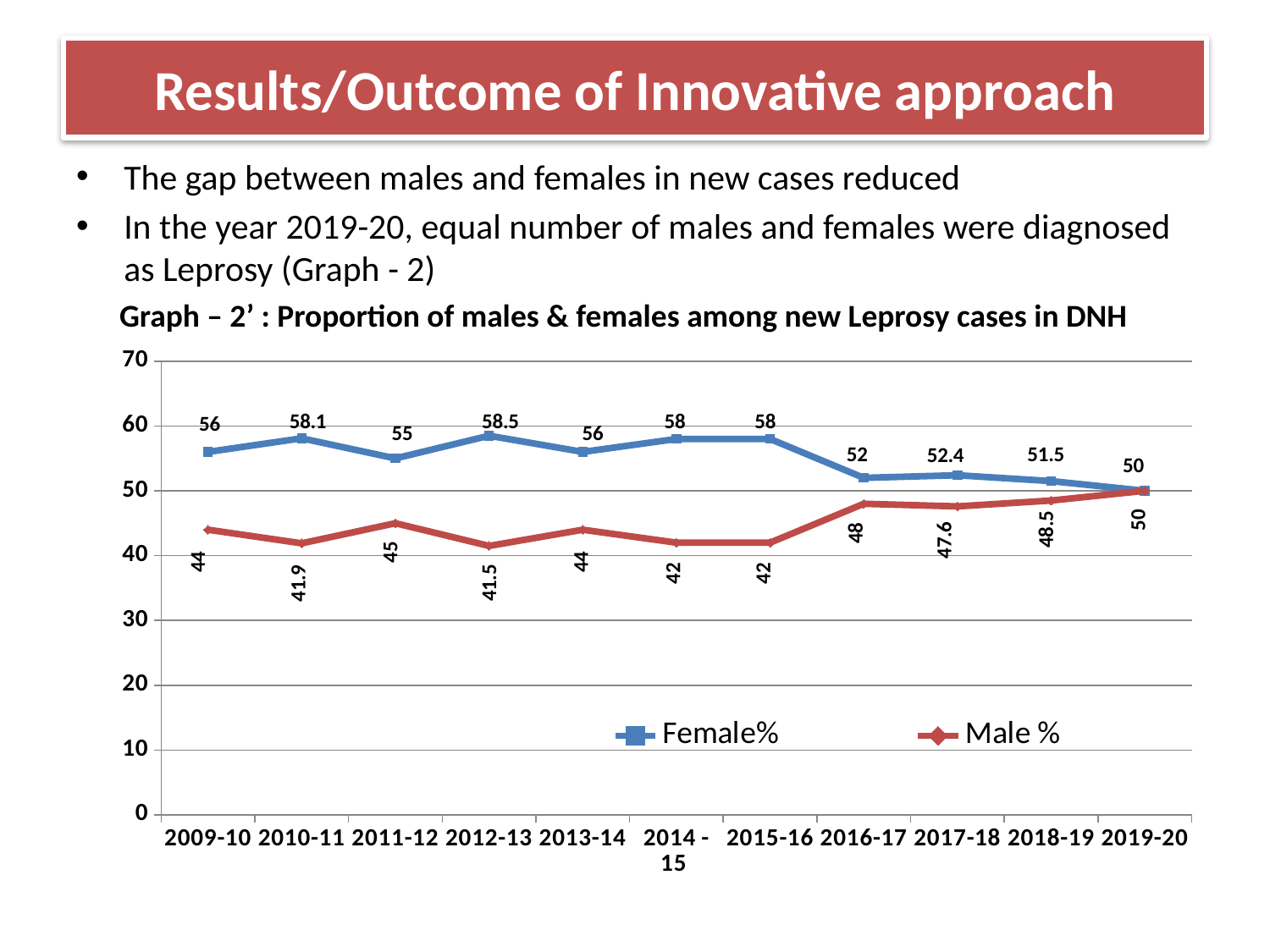
How many years are shown on the x axis? 11 What kind of chart is shown? Line chart In which year is the Male % value highest? 2019-20 What is the Female% value for 2012-13? 58.5 What is the difference between the Female% values for 2015-16 and 2016-17? 6 Does the Male % series rise or fall from 2015-16 to 2019-20? Rise What is the difference between the Female% and Male % values in 2009-10? 12 What is the Male % value for 2010-11? 41.9 What is the Male % value for 2017-18? 47.6 How many series does the legend list? 2 In which year is the Female% value lowest? 2019-20 Which is larger in 2018-19, the Female% value or the Male % value? Female%